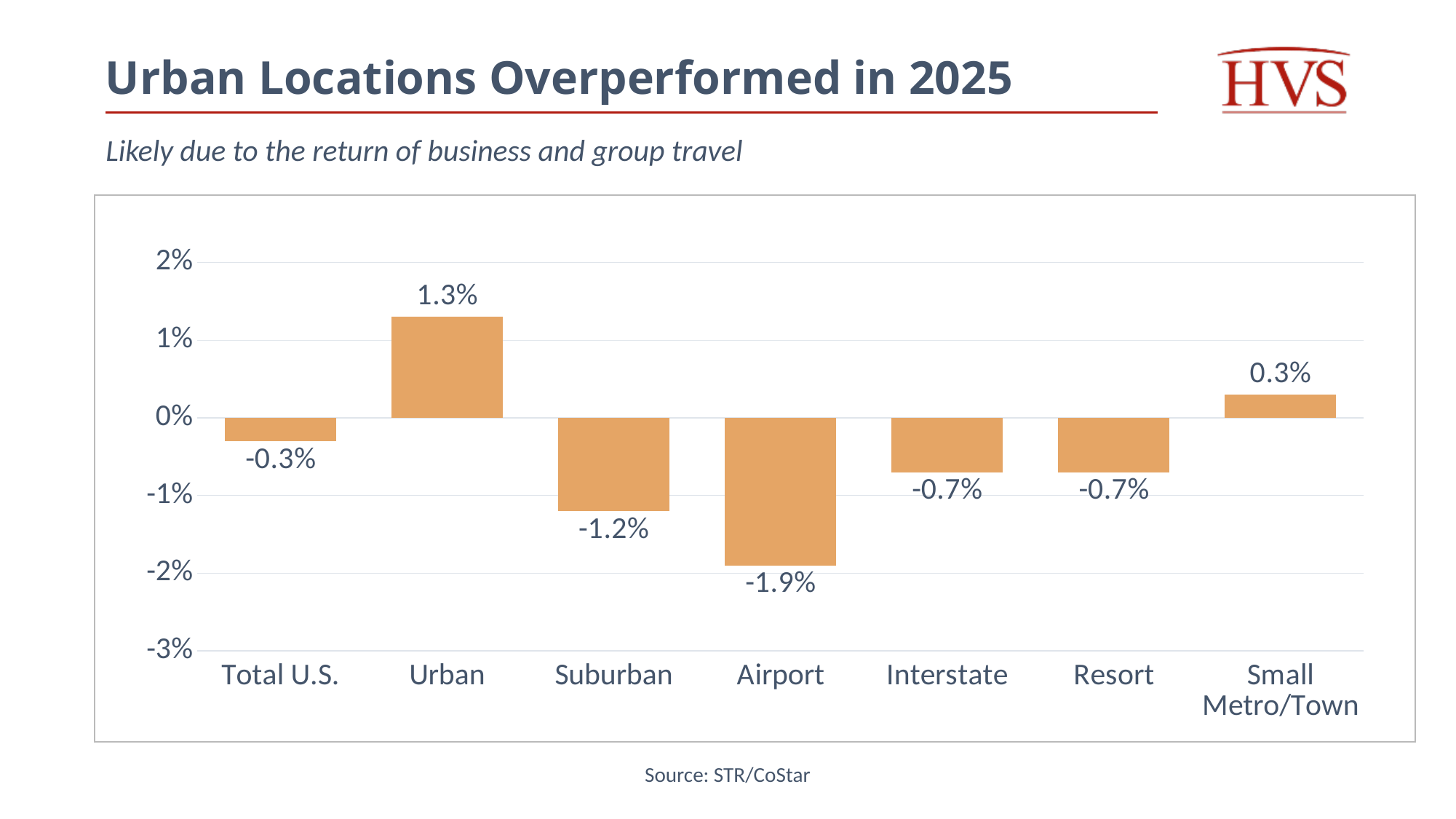
What is the value for Total U.S.? -0.3% What kind of chart is shown on the slide? bar chart What is the value for Airport? -1.9% Which category has the highest value? Urban How many categories are shown on the x axis? 7 What is the value for Urban? 1.3% What is the difference between the values for Urban and Suburban? 2.5% What is the value for Small Metro/Town? 0.3% Is the value for Airport greater or less than -1%? less What is the source cited below the chart? STR/CoStar Which category has the lowest value? Airport Which is larger, the value for Suburban or the value for Interstate? Interstate